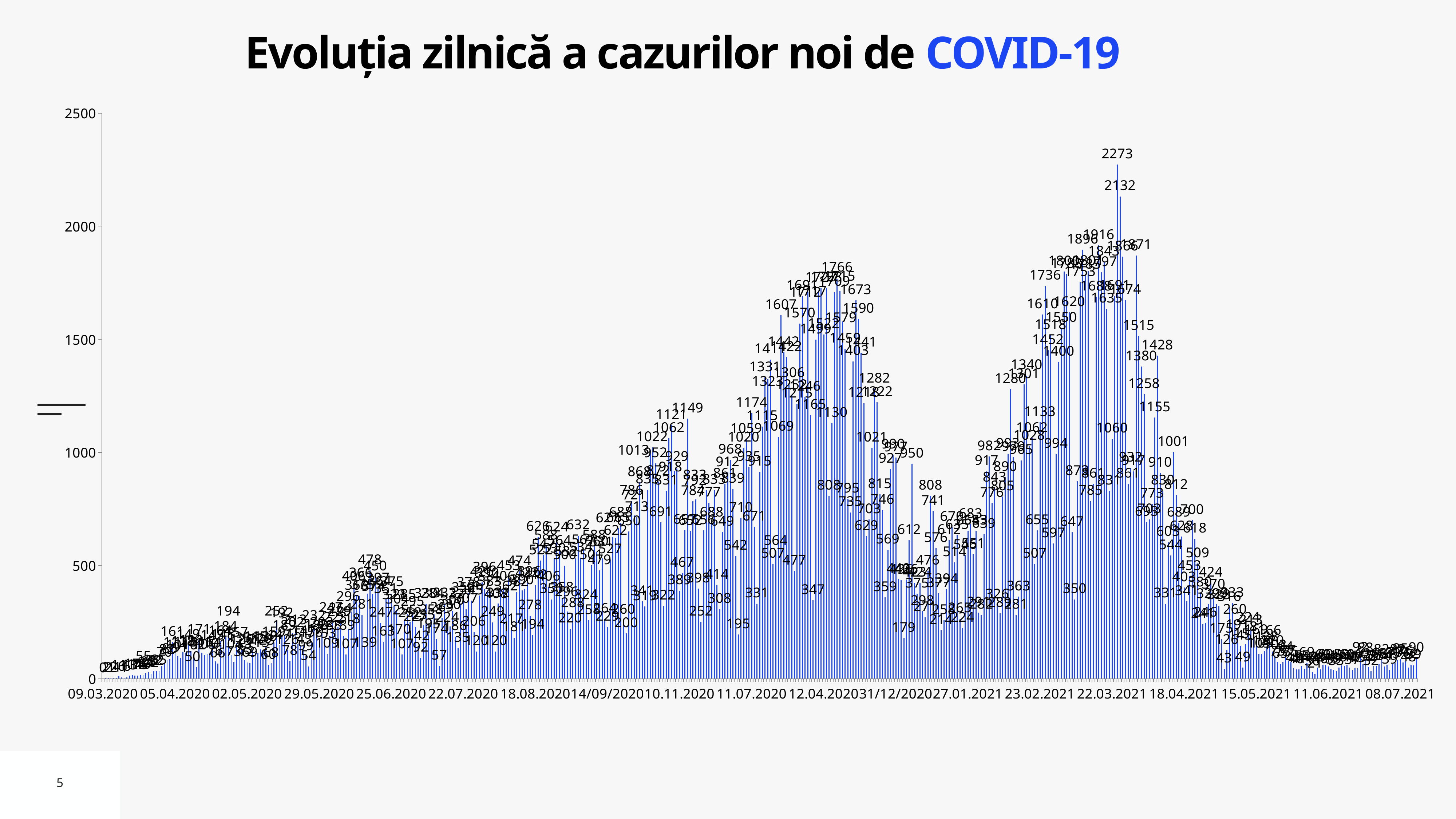
What kind of chart is shown on the slide? bar chart What is the highest daily value labelled on the chart? 2273 What is the difference between the two highest labelled values, 2273 and 2132? 141 What is the title of the chart? Evoluția zilnică a cazurilor noi de COVID-19 Is the value for 22.03.2021 greater or less than 1000? greater How many date labels are shown on the x axis? 19 What is the second-highest daily value labelled on the chart, next to the 2273 peak? 2132 What is the highest tick value shown on the y axis? 2500 Do the values rise or fall along the x axis from 22.03.2021 to 08.07.2021? fall Is the highest value on the chart greater or less than 2000? greater Is the value for the last date, 08.07.2021, greater or less than 500? less Which is larger: the peak of the spring 2021 wave (2273) or the peak of the late 2020 wave (1766)? 2273